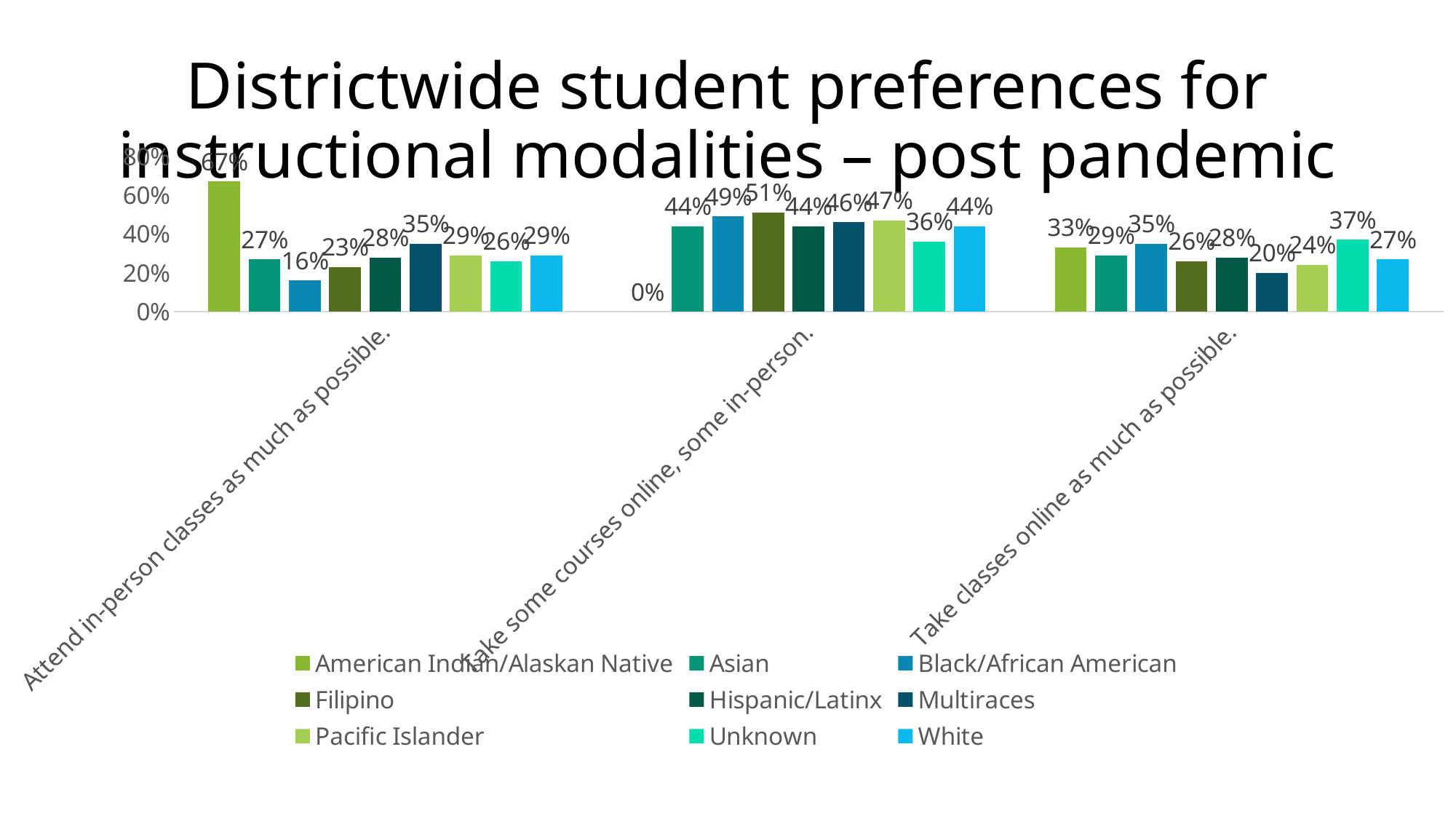
How many categories are shown on the x axis? 3 What is the difference between the Multiraces value and the Black/African American value in the 'Attend in-person classes as much as possible.' category? 19% What is the title of the chart? Districtwide student preferences for instructional modalities – post pandemic What is the value for Unknown in the 'Take classes online as much as possible.' category? 37% What is the value for American Indian/Alaskan Native in the 'Take some courses online, some in-person.' category? 0% What is the value for American Indian/Alaskan Native in the 'Attend in-person classes as much as possible.' category? 67% How many series does the legend list? 9 What type of chart is shown on the slide? bar chart What is the value for Filipino in the 'Take some courses online, some in-person.' category? 51% Which series has the lowest value in the 'Attend in-person classes as much as possible.' category? Black/African American Which series has the lowest value in the 'Take classes online as much as possible.' category? Multiraces Which is larger in the 'Take some courses online, some in-person.' category: the Black/African American value or the Unknown value? Black/African American